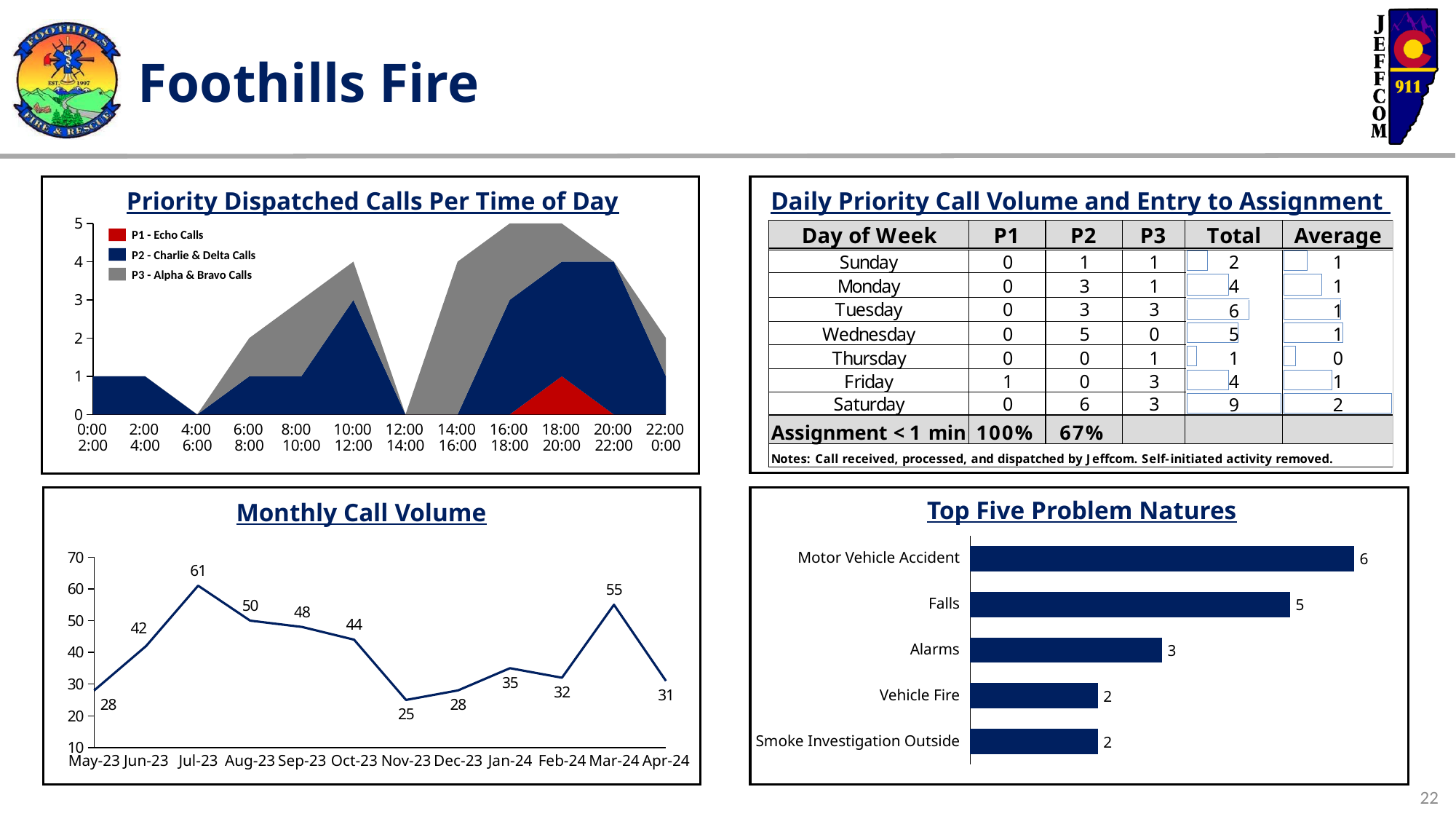
In the Monthly Call Volume chart, do the values rise or fall from Jul-23 to Nov-23? fall What kind of chart is the Top Five Problem Natures chart? bar chart In the Top Five Problem Natures chart, which problem nature has the highest value? Motor Vehicle Accident In the Monthly Call Volume chart, what is the difference between the values for Mar-24 and Apr-24? 24 In the Monthly Call Volume chart, which is larger, the value for Aug-23 or the value for Oct-23? Aug-23 In the Top Five Problem Natures chart, what is the difference between Motor Vehicle Accident and Alarms? 3 In the Monthly Call Volume chart, how many months are plotted? 12 In the Top Five Problem Natures chart, what is the value for Falls? 5 In the Monthly Call Volume chart, which month has the lowest call volume? Nov-23 In the Monthly Call Volume chart, which month has the highest call volume? Jul-23 In the Monthly Call Volume chart, what is the value for Jul-23? 61 How many series does the legend of the Priority Dispatched Calls Per Time of Day chart list? 3